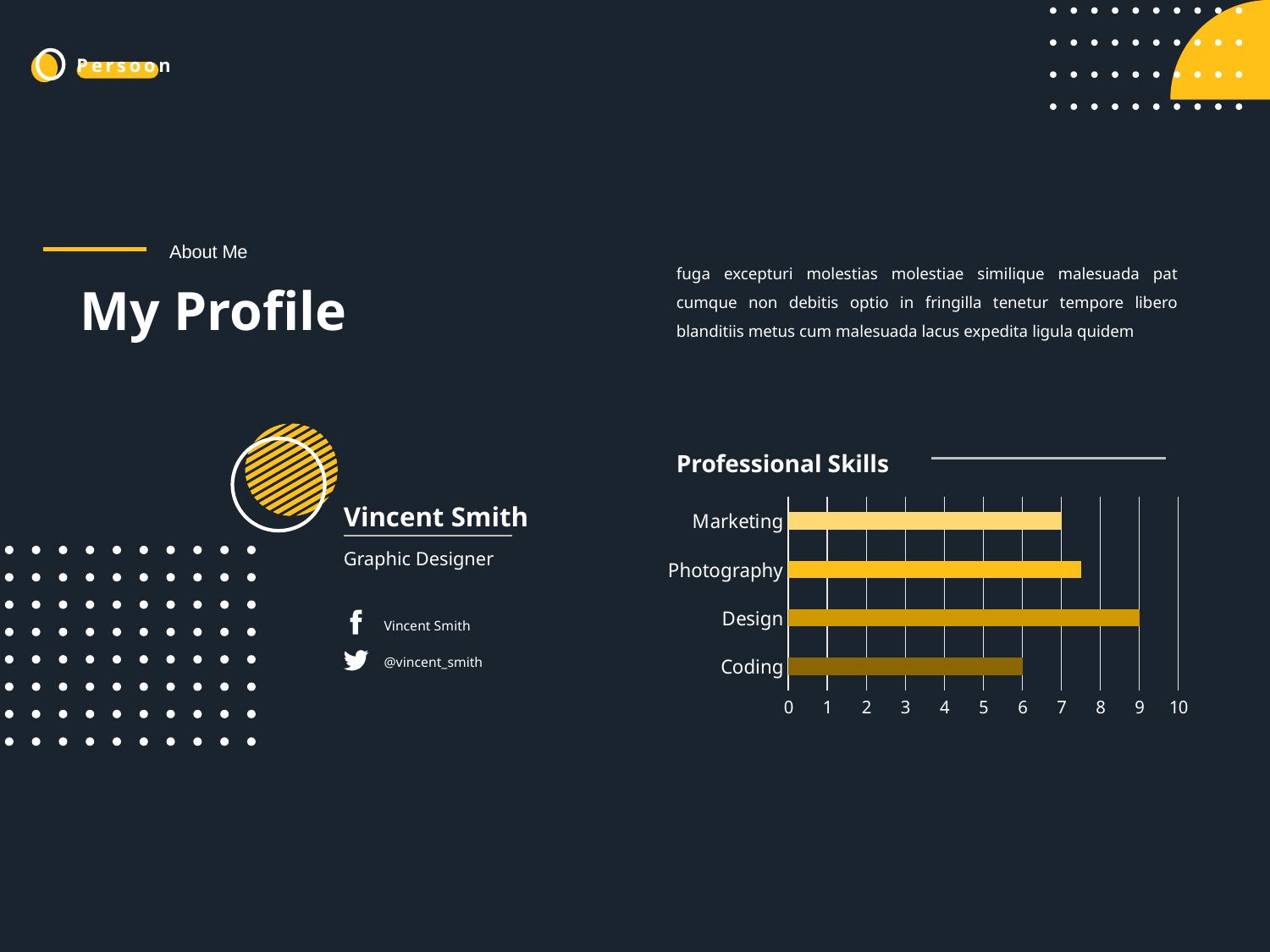
What is the difference between the values for Design and Coding? 3 What type of chart is shown under the heading Professional Skills? bar chart How many skill categories are plotted in the Professional Skills chart? 4 Which is larger, the value for Design or the value for Marketing? Design What is the value for Design in the Professional Skills chart? 9 What is the title of the chart on the slide? Professional Skills Which skill has the lowest value in the Professional Skills chart? Coding What is the value for Marketing in the Professional Skills chart? 7 What is the value for Coding in the Professional Skills chart? 6 Is the value for Photography greater or less than 7? greater Which skill has the highest value in the Professional Skills chart? Design Is the value for Photography greater or less than 8? less